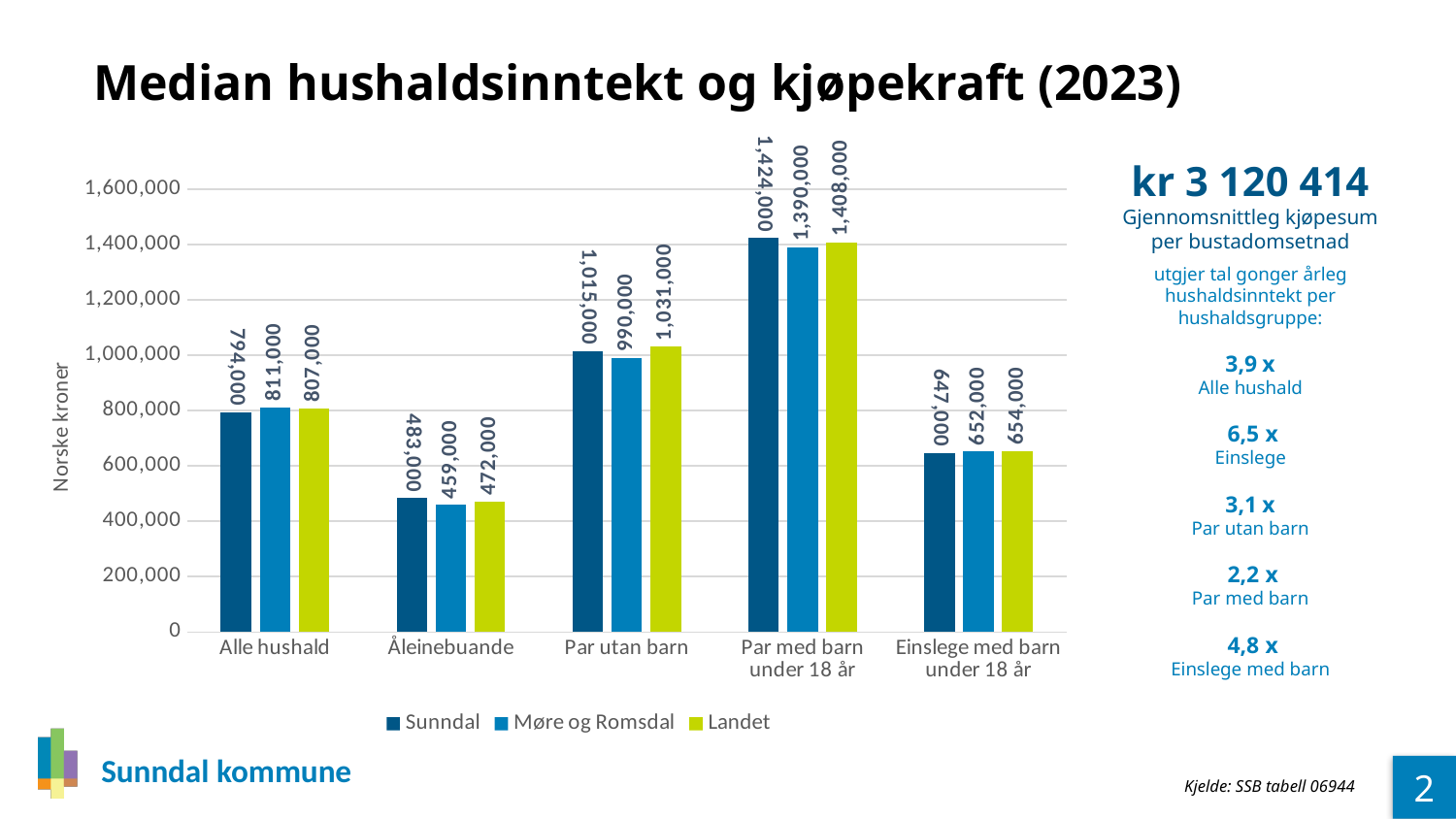
Which category has the lowest value for Landet? Åleinebuande Is the value for Landet in the Einslege med barn under 18 år category greater or less than 800,000? less How many categories are shown on the x axis? 5 What is the value for Møre og Romsdal in the Par med barn under 18 år category? 1,390,000 What is the value for Landet in the Par utan barn category? 1,031,000 What is the value for Sunndal in the Alle hushald category? 794,000 What kind of chart is shown on the slide? bar chart What is the difference between the Sunndal and Møre og Romsdal values in the Par med barn under 18 år category? 34,000 Which category has the highest value for Sunndal? Par med barn under 18 år How many series does the legend list? 3 In the Åleinebuande category, which is larger: Sunndal or Landet? Sunndal What is the value for Sunndal in the Åleinebuande category? 483,000